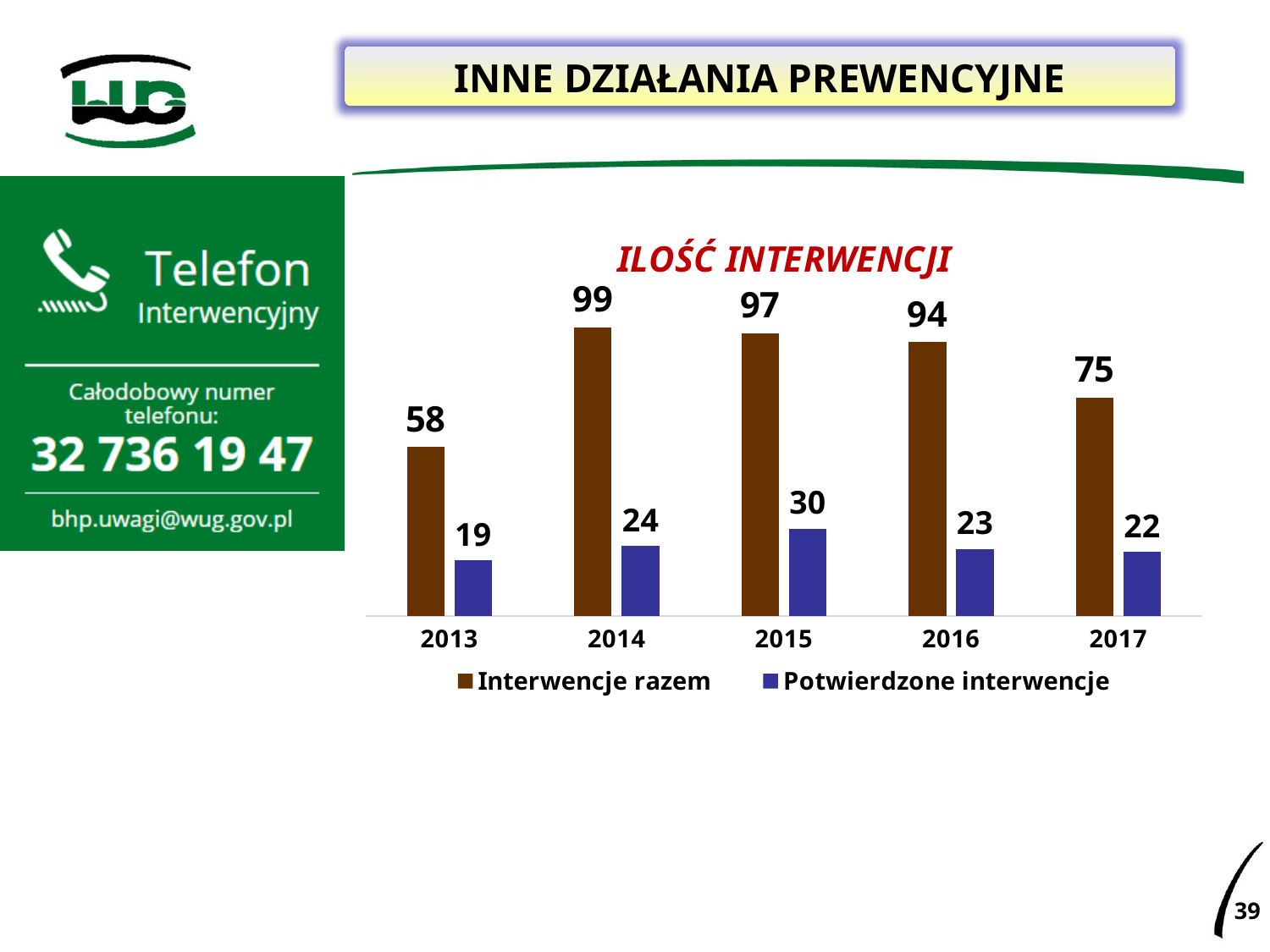
Which is larger: Potwierdzone interwencje in 2014 or in 2016? 2014 What kind of chart is shown? bar chart What is the title of the chart? ILOŚĆ INTERWENCJI How many years are shown on the x axis? 5 Which year has the highest value for Interwencje razem? 2014 What is the value of Interwencje razem for 2014? 99 What is the value of Potwierdzone interwencje for 2015? 30 How many series does the legend list? 2 Does Interwencje razem rise or fall from 2014 to 2017? fall What colour are the bars for Potwierdzone interwencje? blue What is the difference between Interwencje razem and Potwierdzone interwencje in 2017? 53 Which year has the lowest value for Potwierdzone interwencje? 2013